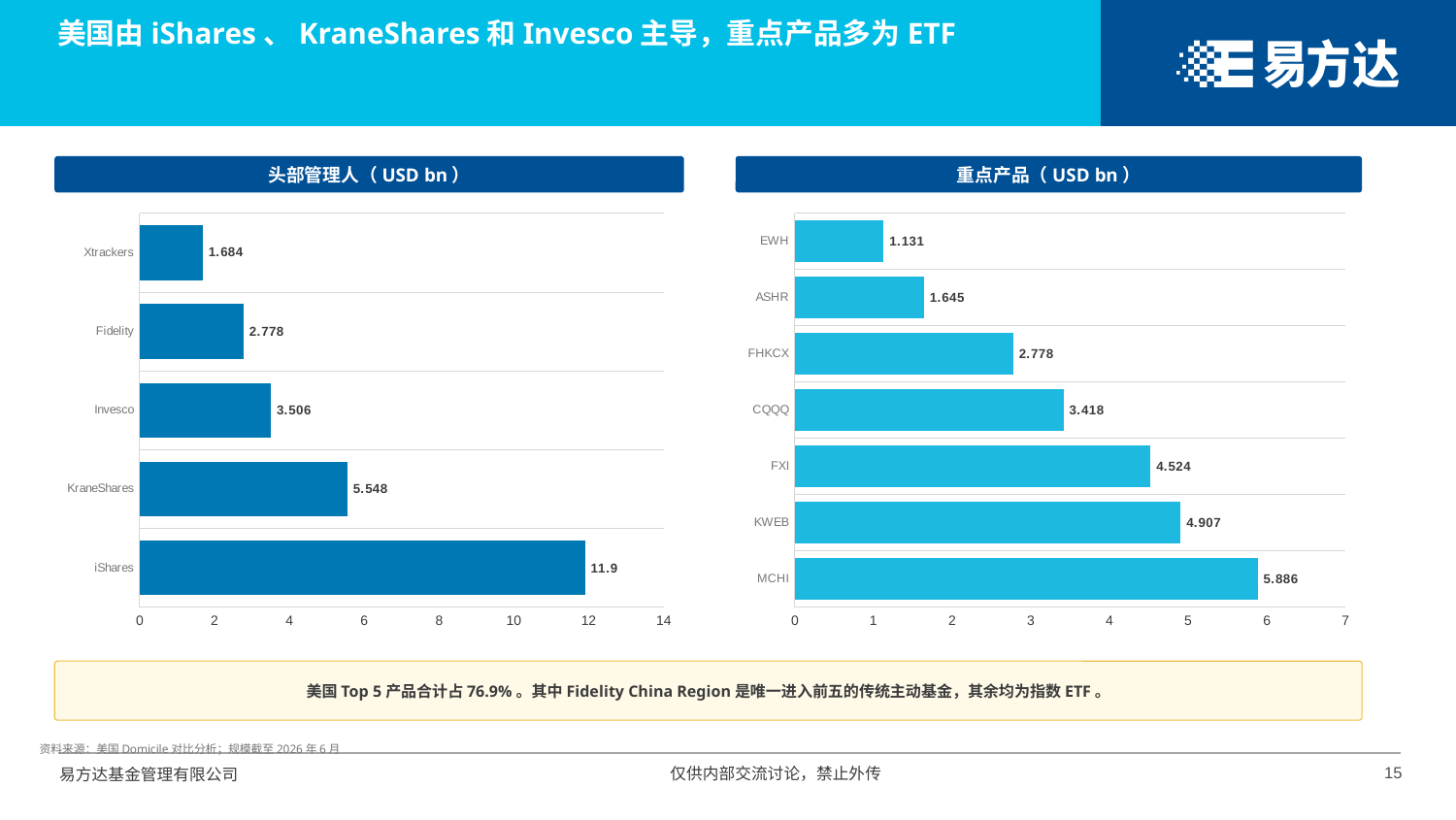
In the 重点产品（USD bn） chart, which product has the highest value? MCHI In the 重点产品（USD bn） chart, how many products are shown? 7 In the 重点产品（USD bn） chart, which product has the lowest value? EWH What type of chart is the 头部管理人（USD bn） chart? Bar chart In the 头部管理人（USD bn） chart, which manager has the lowest value? Xtrackers In the 重点产品（USD bn） chart, what is the difference between MCHI and KWEB? 0.979 In the 头部管理人（USD bn） chart, which manager has the highest value? iShares In the 重点产品（USD bn） chart, which is larger, FXI or KWEB? KWEB In the 头部管理人（USD bn） chart, what is the difference between iShares and KraneShares? 6.352 In the 头部管理人（USD bn） chart, how many managers are shown? 5 In the 头部管理人（USD bn） chart, what is the value for KraneShares? 5.548 In the 重点产品（USD bn） chart, what is the value for CQQQ? 3.418